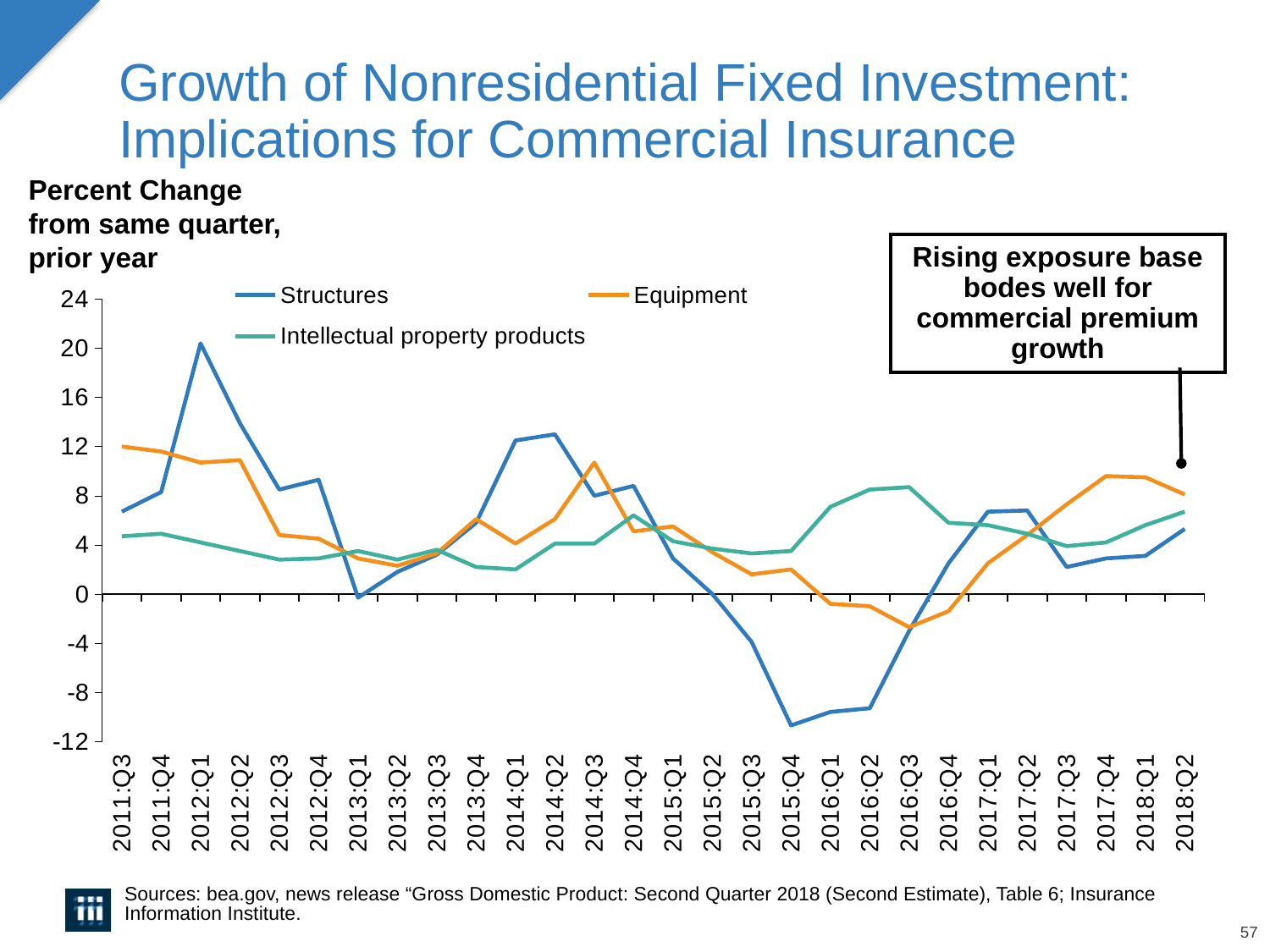
In which quarter does the Structures series reach its lowest value? 2015:Q4 Is the value for Equipment in 2016:Q3 greater or less than 0? less Is the value for Structures in 2012:Q1 greater or less than 16? greater Is the value for Structures in 2015:Q4 greater or less than -8? less In which quarter does the Structures series reach its highest value? 2012:Q1 In 2016:Q2, which is larger: Intellectual property products or Structures? Intellectual property products What colour is the Equipment line? orange How many quarters are plotted along the x axis? 28 Which series reaches the highest value anywhere on the chart? Structures Does the Structures series rise or fall from 2014:Q2 to 2015:Q4? fall What kind of chart is shown on the slide? line chart How many series does the legend list? 3